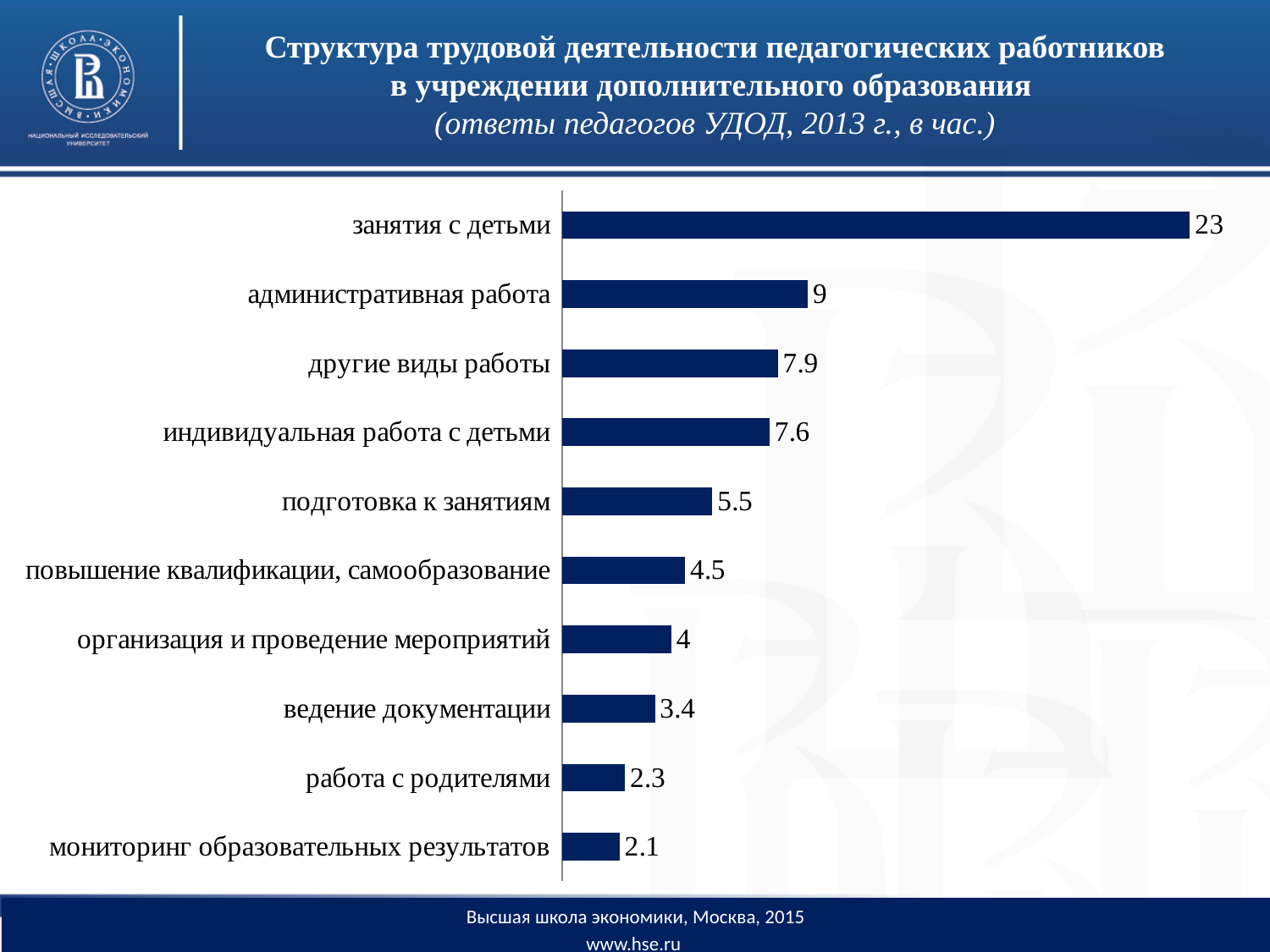
What kind of chart is shown on the slide? bar chart What is the difference between the values for "занятия с детьми" and "административная работа"? 14 What is the difference between the values for "другие виды работы" and "индивидуальная работа с детьми"? 0.3 Which is larger: the value for "повышение квалификации, самообразование" or the value for "организация и проведение мероприятий"? повышение квалификации, самообразование What is the value for "занятия с детьми"? 23 Which category has the lowest value? мониторинг образовательных результатов In what unit are the values in the chart expressed, according to the title? в час. (hours) Which category has the highest value? занятия с детьми What is the value for "работа с родителями"? 2.3 How many categories are shown in the chart? 10 What is the value for "подготовка к занятиям"? 5.5 What is the value for "ведение документации"? 3.4